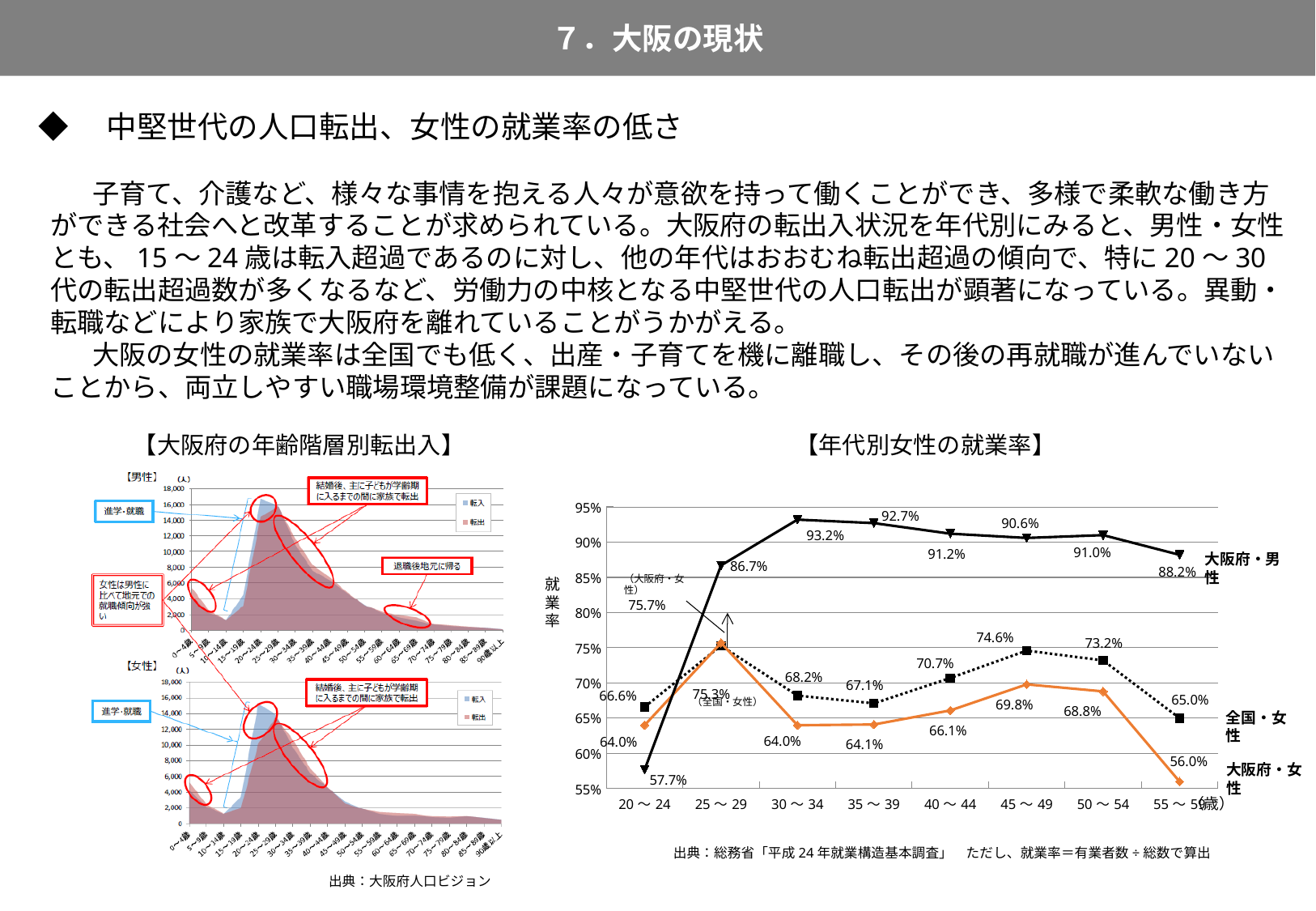
In the 年代別女性の就業率 chart, which age group has the highest value for 大阪府・女性? 25～29 In the 年代別女性の就業率 chart, which is larger in the 40～44 age group: 全国・女性 or 大阪府・女性? 全国・女性 What kind of chart is the 年代別女性の就業率 chart on the right? line chart In the 大阪府の年齢階層別転出入 charts on the left, how many series does the legend list? 2 In the 年代別女性の就業率 chart, does the 大阪府・男性 line rise or fall from 30～34 to 55～59? fall In the 年代別女性の就業率 chart, what is the difference between 全国・女性 and 大阪府・女性 in the 55～59 age group? 9.0% In the 年代別女性の就業率 chart, what is the value for 大阪府・男性 in the 30～34 age group? 93.2% In the 年代別女性の就業率 chart, what is the value for 大阪府・女性 in the 55～59 age group? 56.0% In the 年代別女性の就業率 chart, which age group has the lowest value for 大阪府・男性? 20～24 In the 年代別女性の就業率 chart, how many age groups are shown on the x axis? 8 In the 年代別女性の就業率 chart, what is the value for 全国・女性 in the 45～49 age group? 74.6% In the 年代別女性の就業率 chart, how many series are plotted? 3